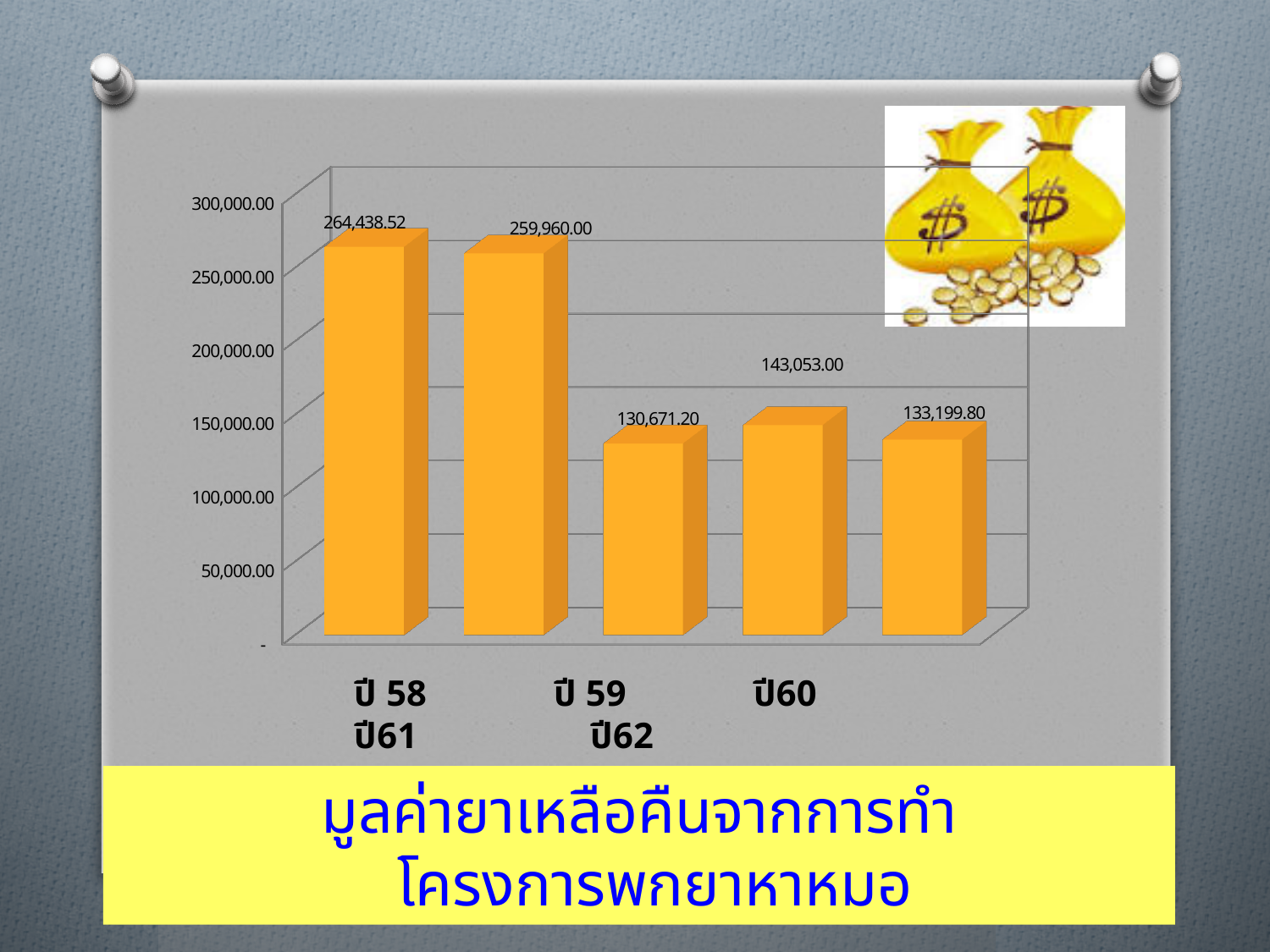
Do the values generally rise or fall from ปี 58 to ปี62? fall What is the value shown for ปี 58? 264,438.52 Is the value for ปี60 greater or less than 150,000.00? less What is the title shown in the yellow box below the chart? มูลค่ายาเหลือคืนจากการทำโครงการพกยาหาหมอ What is the value shown for ปี62? 133,199.80 How many bars are plotted in the chart? 5 Which year has the lowest value in the chart? ปี60 What kind of chart is shown on the slide? bar chart What is the value shown for ปี 59? 259,960.00 What is the difference between the values for ปี 58 and ปี 59? 4,478.52 Which year has the highest value in the chart? ปี 58 Which is larger, the value for ปี61 or the value for ปี62? ปี61